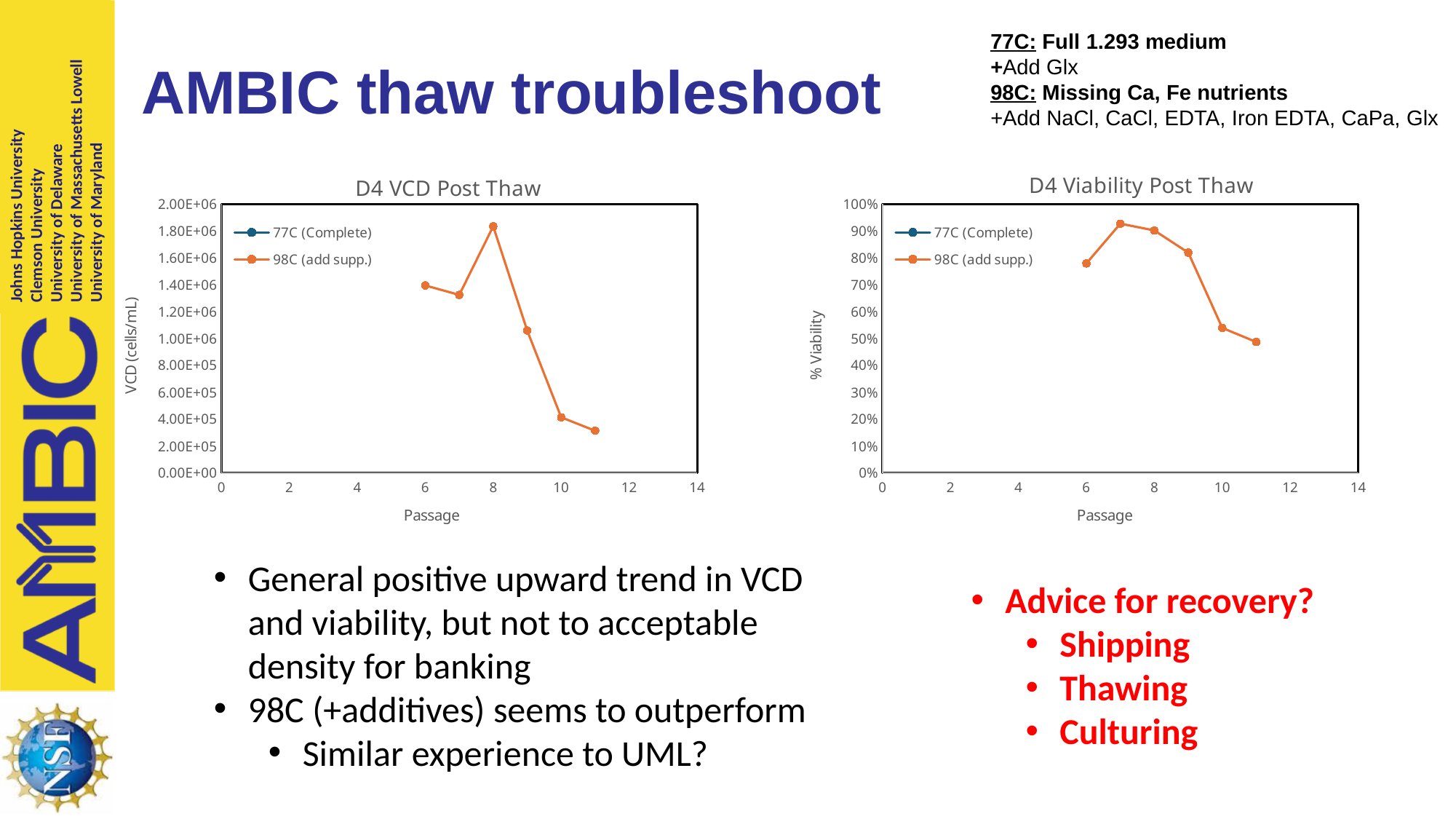
In the "D4 Viability Post Thaw" chart, is the 98C (add supp.) viability at passage 10 greater or less than 60%? less In the "D4 VCD Post Thaw" chart, is the 98C (add supp.) value at passage 8 greater or less than 1.60E+06? greater In the "D4 Viability Post Thaw" chart, does the 98C (add supp.) viability rise or fall from passage 8 to passage 11? fall In the "D4 Viability Post Thaw" chart, at which passage is the 98C (add supp.) viability lowest? 11 In the "D4 VCD Post Thaw" chart, how many data points are plotted for the 98C (add supp.) series? 6 In the "D4 VCD Post Thaw" chart, is the 98C (add supp.) value at passage 10 greater or less than 6.00E+05? less In the "D4 VCD Post Thaw" chart, at which passage does the 98C (add supp.) series reach its highest VCD? 8 What kind of chart is the "D4 VCD Post Thaw" chart? line chart How many series does the legend of the "D4 Viability Post Thaw" chart list? 2 In the "D4 VCD Post Thaw" chart, at which passage is the 98C (add supp.) VCD lowest? 11 What is the y-axis label of the "D4 VCD Post Thaw" chart? VCD (cells/mL) In the "D4 Viability Post Thaw" chart, at which passage is the 98C (add supp.) viability highest? 7